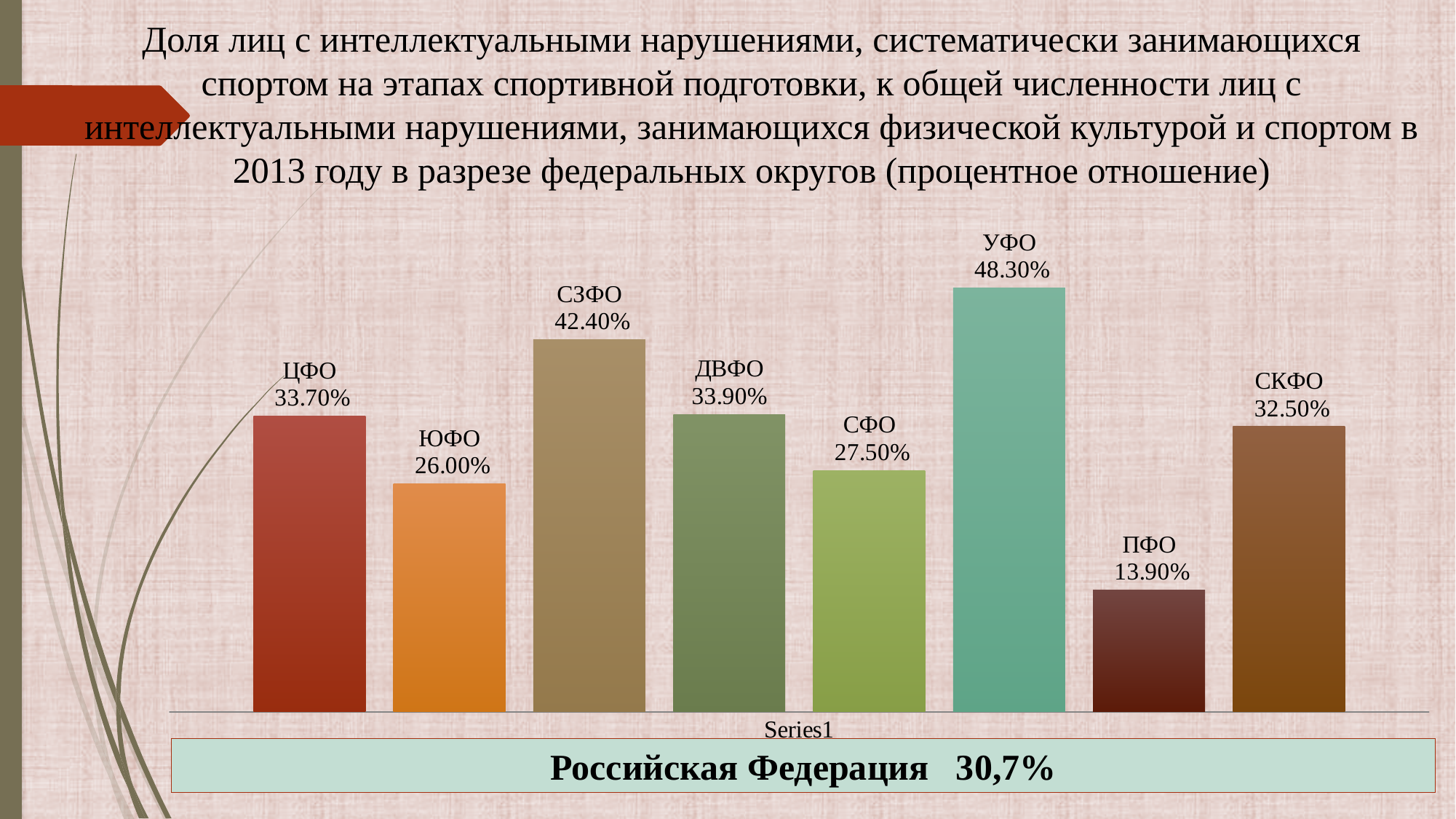
How many federal districts (bars) are shown in the chart? 8 Which federal district has the lowest value in the chart? ПФО What is the value shown for СЗФО? 42.40% What is the value shown for УФО? 48.30% What is the value shown for СКФО? 32.50% Which federal district has the highest value in the chart? УФО What value is shown for Российская Федерация in the box below the chart? 30,7% Which has a larger value, СЗФО or ЮФО? СЗФО What type of chart is shown on the slide? bar chart What is the difference between the values for УФО and ПФО? 34.40 percentage points What is the value shown for ПФО? 13.90% What is the difference between the values for СЗФО and ЮФО? 16.40 percentage points